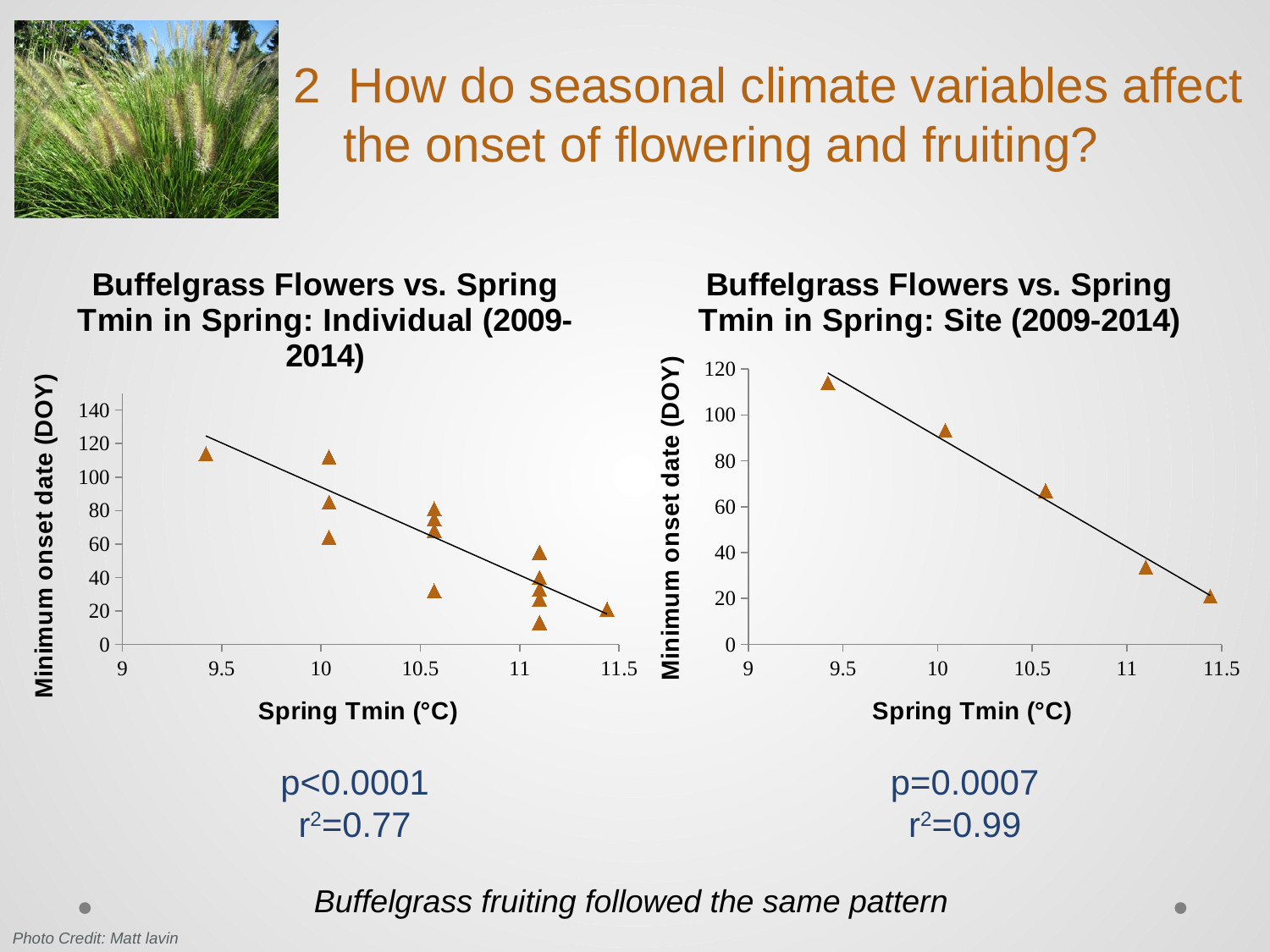
In the right-hand chart (Site), which has the larger minimum onset date: the point near Spring Tmin 10 or the point near Spring Tmin 11? the point near Spring Tmin 10 In the left-hand chart (Individual), is the lowest plotted minimum onset date greater or less than 20? less In the left-hand chart (Individual), do the minimum onset dates generally rise or fall as Spring Tmin increases? fall What is the y-axis title of the right-hand chart (Site)? Minimum onset date (DOY) What kind of chart is the chart titled "Buffelgrass Flowers vs. Spring Tmin in Spring: Individual (2009-2014)"? scatter chart In the right-hand chart (Site), do the minimum onset dates rise or fall as Spring Tmin increases? fall What kind of chart is the chart titled "Buffelgrass Flowers vs. Spring Tmin in Spring: Site (2009-2014)"? scatter chart In the right-hand chart (Site), is the minimum onset date for the point near Spring Tmin 9.5 greater or less than 100? greater In the right-hand chart (Site), is the minimum onset date for the point near Spring Tmin 11.5 greater or less than 40? less How many data points are plotted in the right-hand chart (Site)? 5 What is the x-axis title of the left-hand chart (Individual)? Spring Tmin (°C)